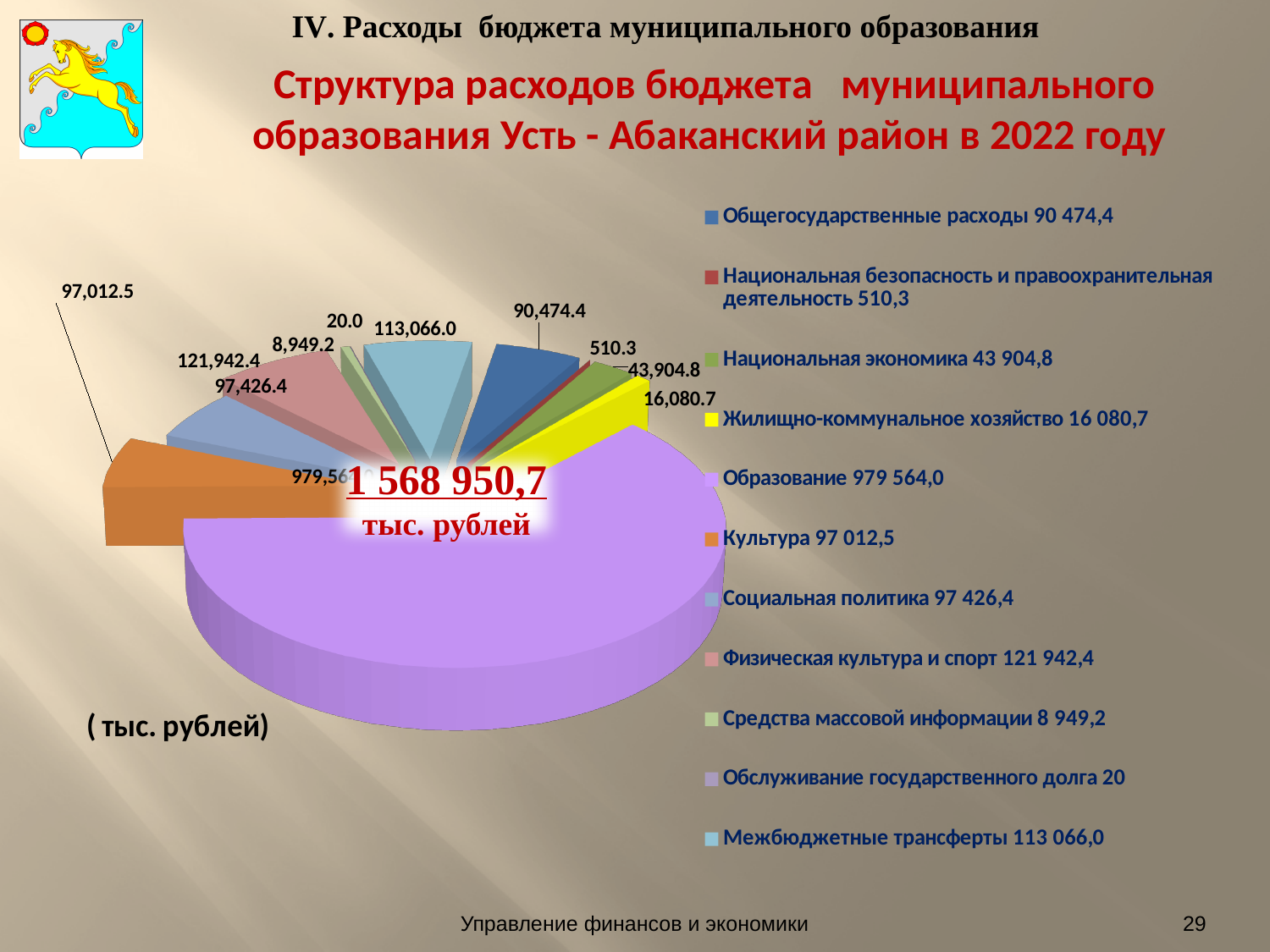
Which is larger: Физическая культура и спорт or Межбюджетные трансферты? Физическая культура и спорт What is the value for Жилищно-коммунальное хозяйство? 16,080.7 What is the difference between Физическая культура и спорт (121,942.4) and Межбюджетные трансферты (113,066.0)? 8,876.4 What is the value for Межбюджетные трансферты (Intergovernmental transfers)? 113,066.0 What is the value for Образование (Education) in the pie chart? 979,564.0 What kind of chart is shown on the slide? Pie chart In what units are the values in the chart expressed, according to the label at the bottom left? тыс. рублей Which category has the largest slice of the pie? Образование How many categories does the pie chart have? 11 What total amount is printed in the centre of the pie chart? 1 568 950,7 тыс. рублей What is the value for Национальная безопасность и правоохранительная деятельность? 510.3 Which category has the smallest value in the pie chart? Обслуживание государственного долга